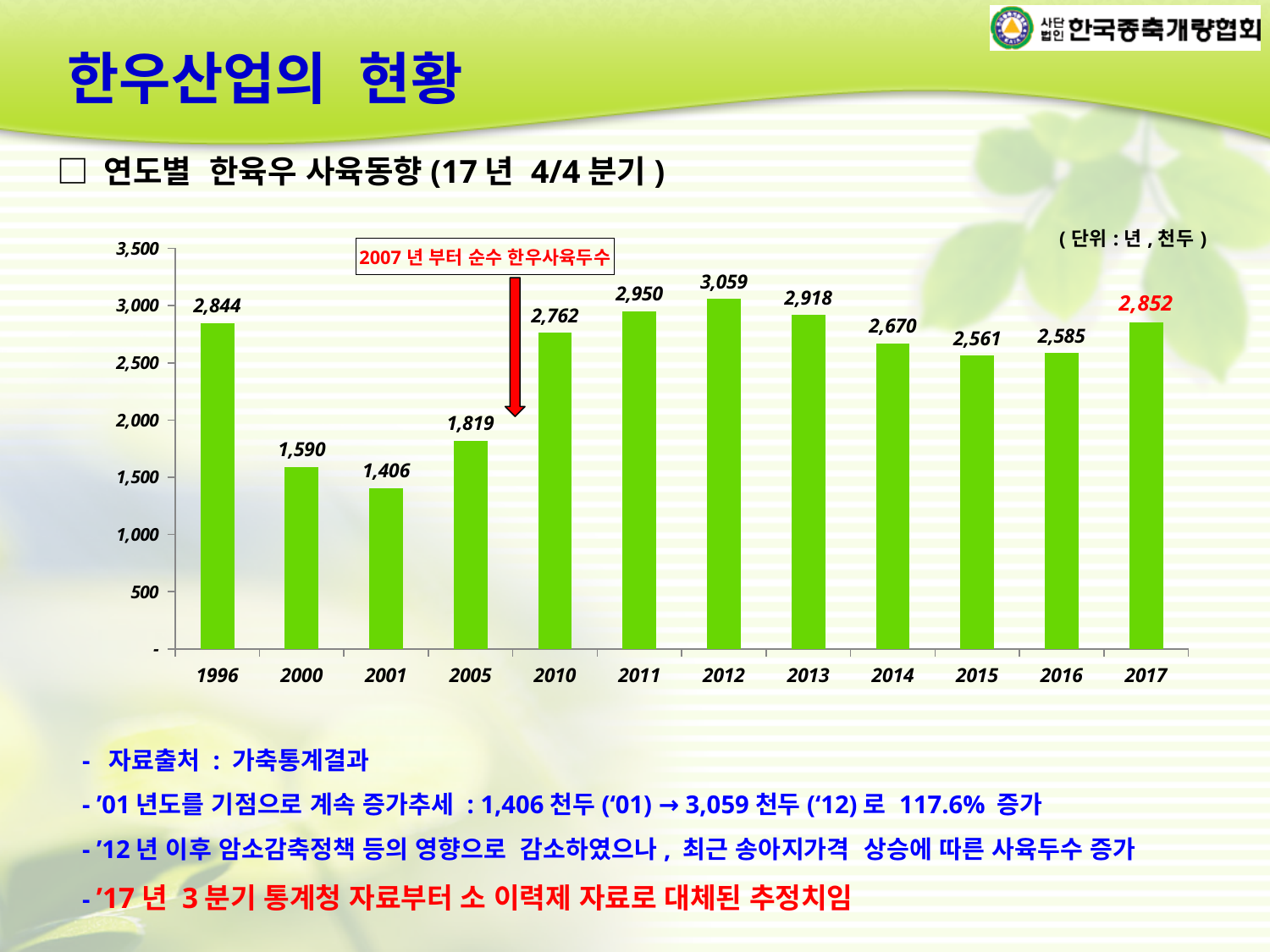
Is the value for 2005 greater or less than 2,000? less What kind of chart is shown on the slide? bar chart Do the values rise or fall from 2012 to 2015? fall What is the value for 2017? 2,852 Which is larger, the value for 1996 or the value for 2010? 1996 What is the difference between the values for 2017 and 2016? 267 What is the value for 2012? 3,059 What is the difference between the values for 2012 and 2001? 1,653 Which year has the lowest value? 2001 How many years are shown on the x axis? 12 What is the value for 2001? 1,406 Which year has the highest value? 2012